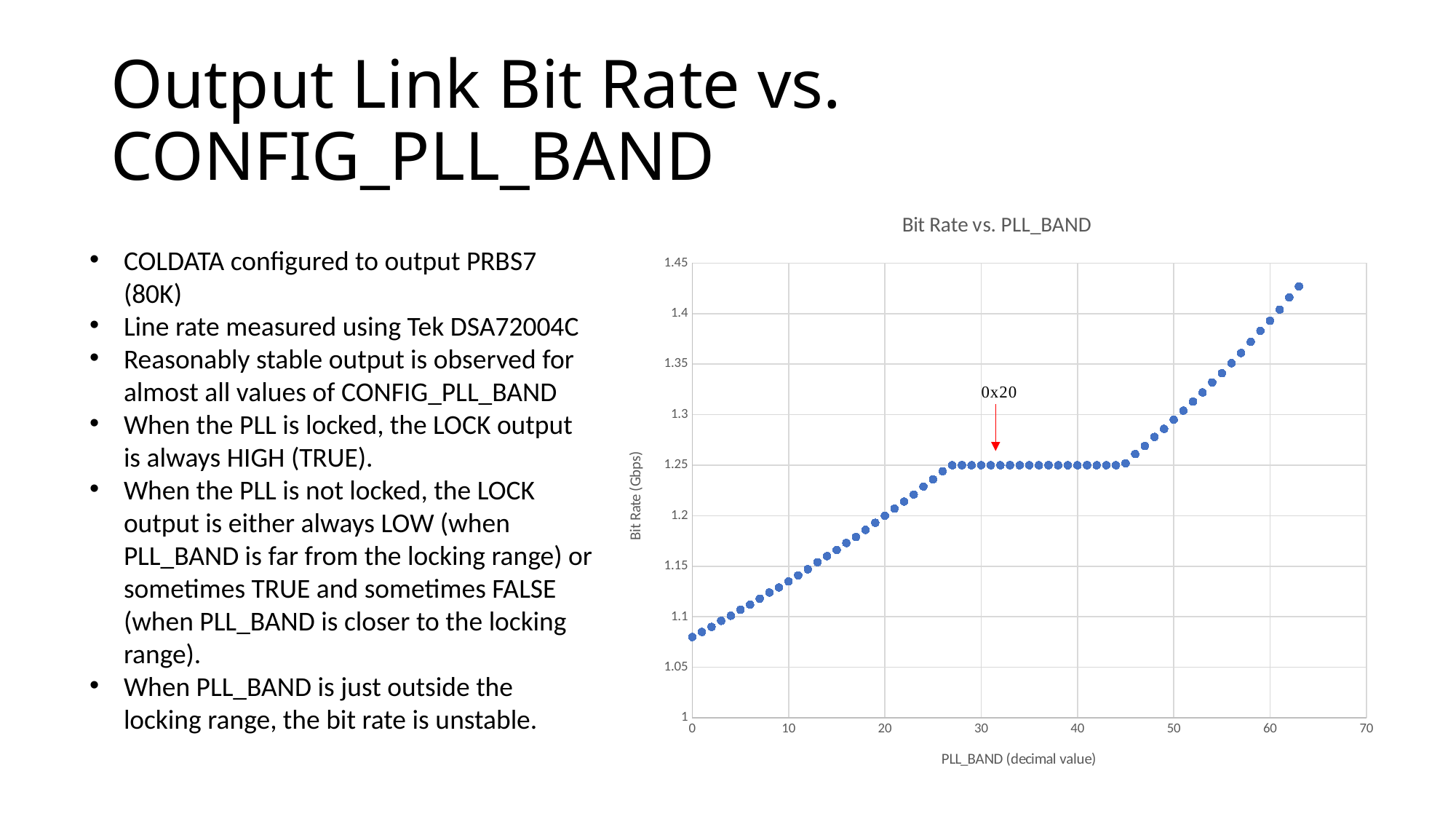
What kind of chart is shown on the slide? scatter chart At which end of the PLL_BAND axis is the bit rate highest? PLL_BAND 63 (right end) What text does the red arrow annotation on the chart show? 0x20 Is the bit rate at the rightmost point (PLL_BAND 63) greater or less than 1.4? greater Which has the higher bit rate, PLL_BAND 10 or PLL_BAND 50? PLL_BAND 50 What bit rate value do the points in the flat plateau region (around PLL_BAND 27 to 45) sit on? 1.25 What is the title of the chart? Bit Rate vs. PLL_BAND At which end of the PLL_BAND axis is the bit rate lowest? PLL_BAND 0 (left end) Is the bit rate at PLL_BAND 55 greater or less than 1.3? greater Does the bit rate generally rise or fall as PLL_BAND increases? rise Is the bit rate at PLL_BAND 10 greater or less than 1.15? less